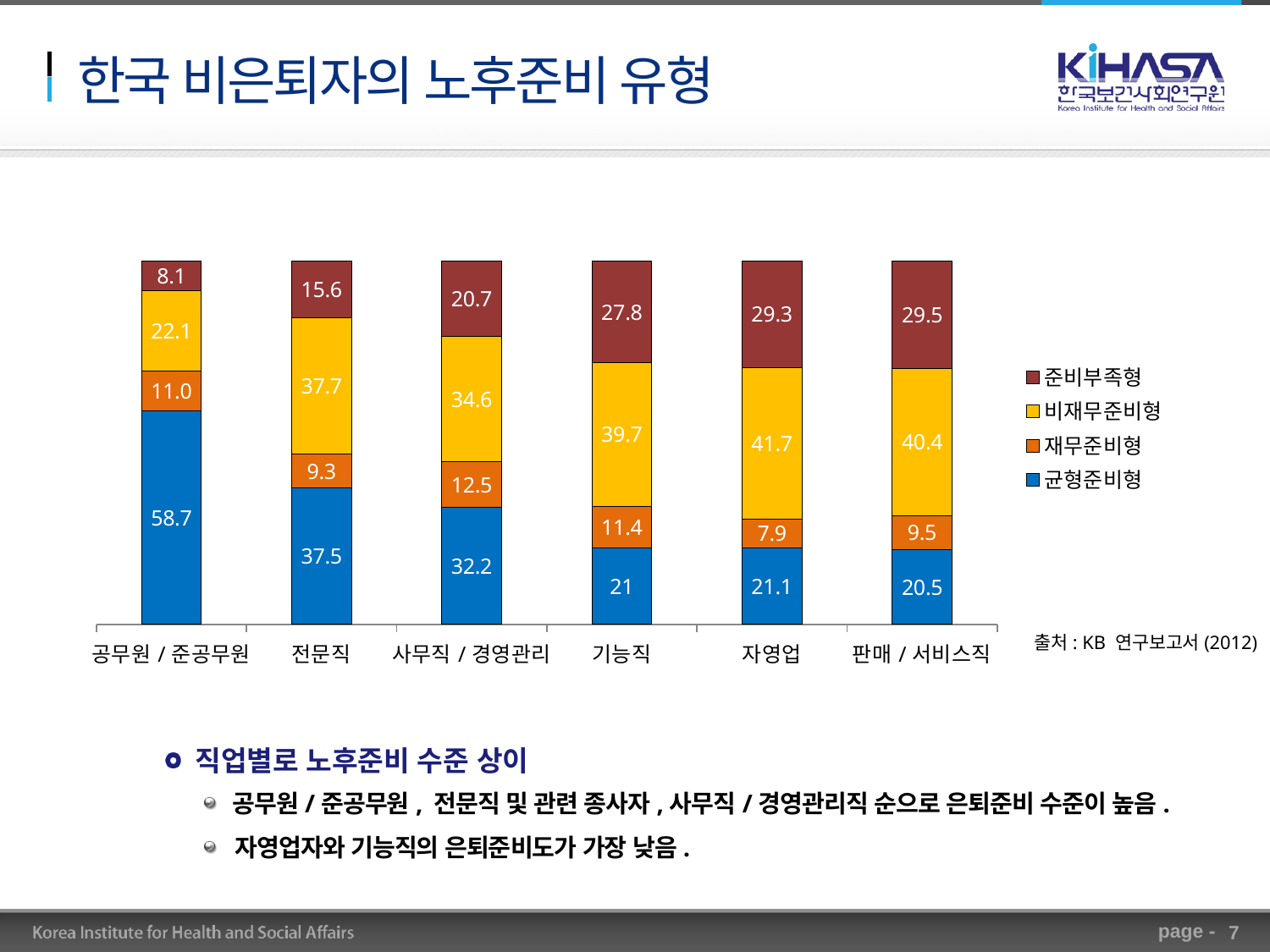
How many occupation categories are shown on the x axis? 6 How many series does the legend list? 4 What kind of chart is shown on the slide? Stacked bar chart What is the difference between the 비재무준비형 values for 자영업 and 공무원 / 준공무원? 19.6 Which colour represents 균형준비형 in the legend? Blue What is the value of 균형준비형 for 공무원 / 준공무원? 58.7 Which is larger, the 재무준비형 value for 사무직 / 경영관리 or for 전문직? 사무직 / 경영관리 Which category has the lowest 재무준비형 value? 자영업 What is the value of 비재무준비형 for 전문직? 37.7 What is the total of the stacked bar for 자영업? 100.0 What is the value of 준비부족형 for 자영업? 29.3 Which category has the highest 균형준비형 value? 공무원 / 준공무원